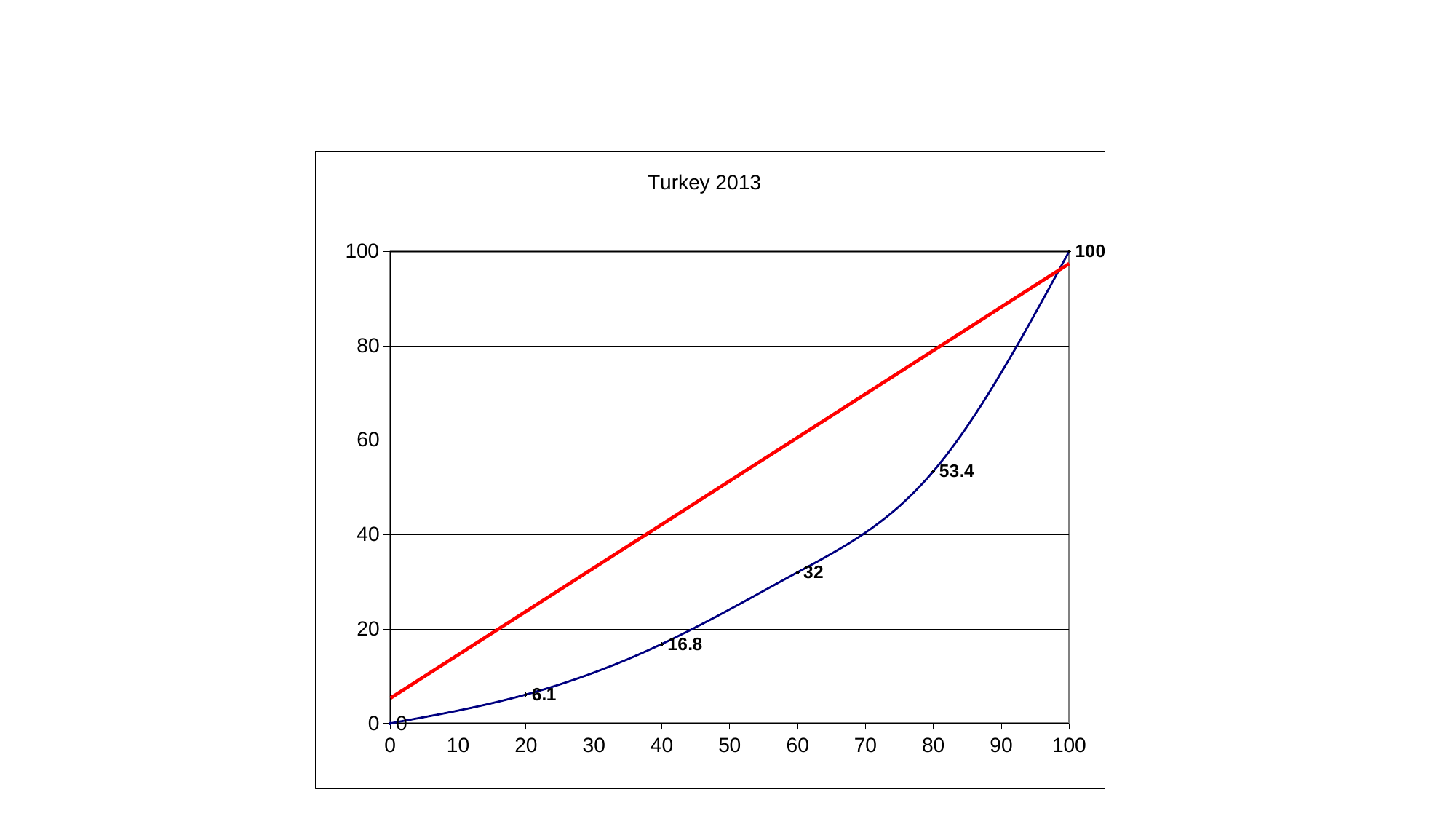
Do the values of the blue curve rise or fall as x increases from 0 to 100? rise What is the labelled value of the blue curve at x = 60? 32 What is the labelled value of the blue curve at x = 20? 6.1 What is the difference between the blue curve's labelled values at x = 80 and x = 60? 21.4 What is the labelled value of the blue curve at x = 100? 100 How many labelled data points are on the blue curve? 6 What is the difference between the blue curve's labelled values at x = 40 and x = 20? 10.7 At x = 60, which line is higher, the red line or the blue curve? the red line What is the labelled value of the blue curve at x = 40? 16.8 What is the labelled value of the blue curve at x = 80? 53.4 What kind of chart is shown on the slide? line chart What is the title of the chart? Turkey 2013